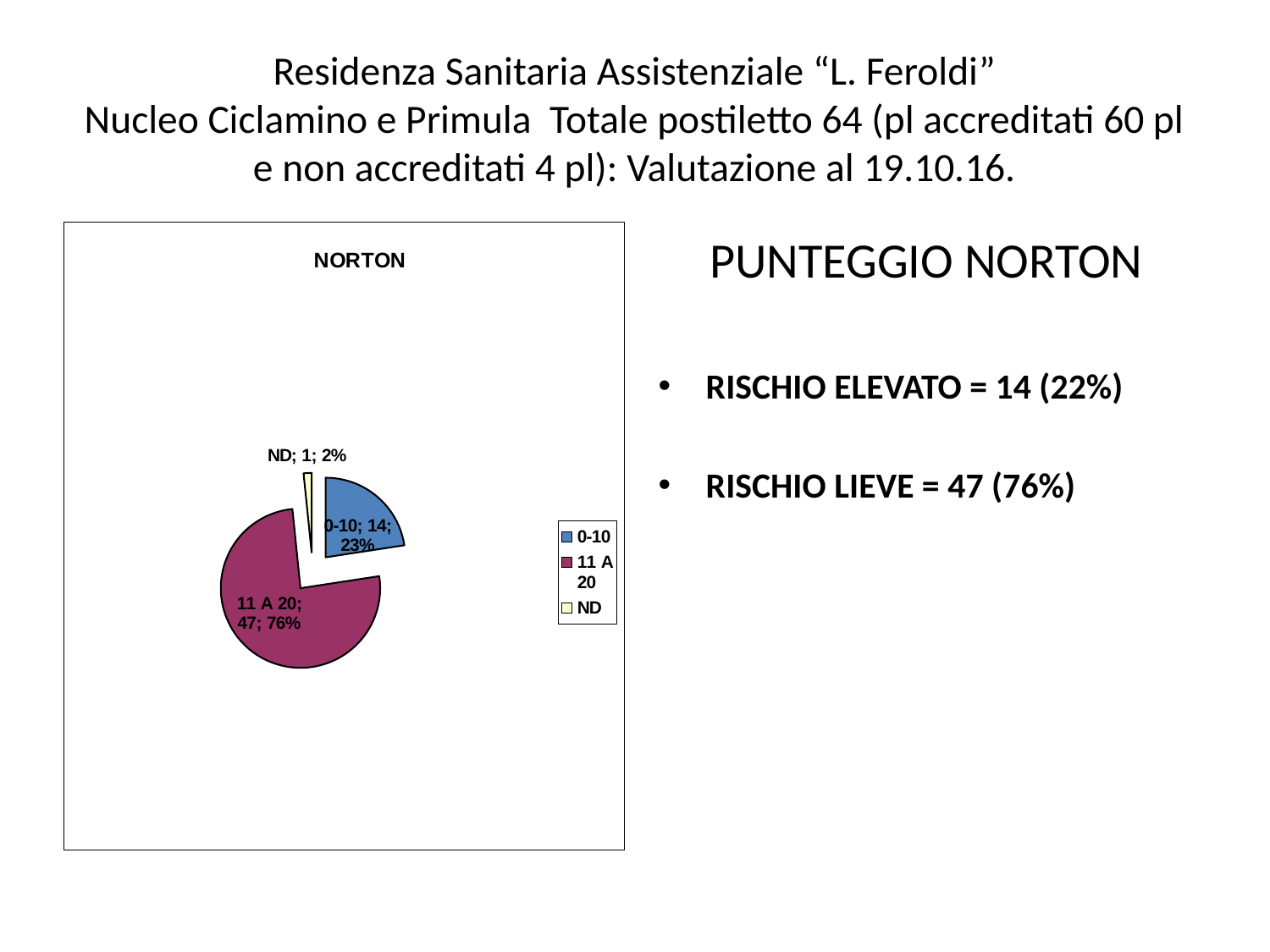
What share of the pie does the 0-10 slice represent? 23% What kind of chart is shown on the slide? pie chart What is the value for the ND slice? 1 How many entries does the legend list? 3 What is the difference between the values for 11 A 20 and 0-10? 33 What is the value for the 0-10 slice? 14 Which category has the largest slice? 11 A 20 Which category has the smallest slice? ND How many slices does the pie chart have? 3 What is the title of the chart? NORTON What is the value for the 11 A 20 slice? 47 What share of the pie does the 11 A 20 slice represent? 76%